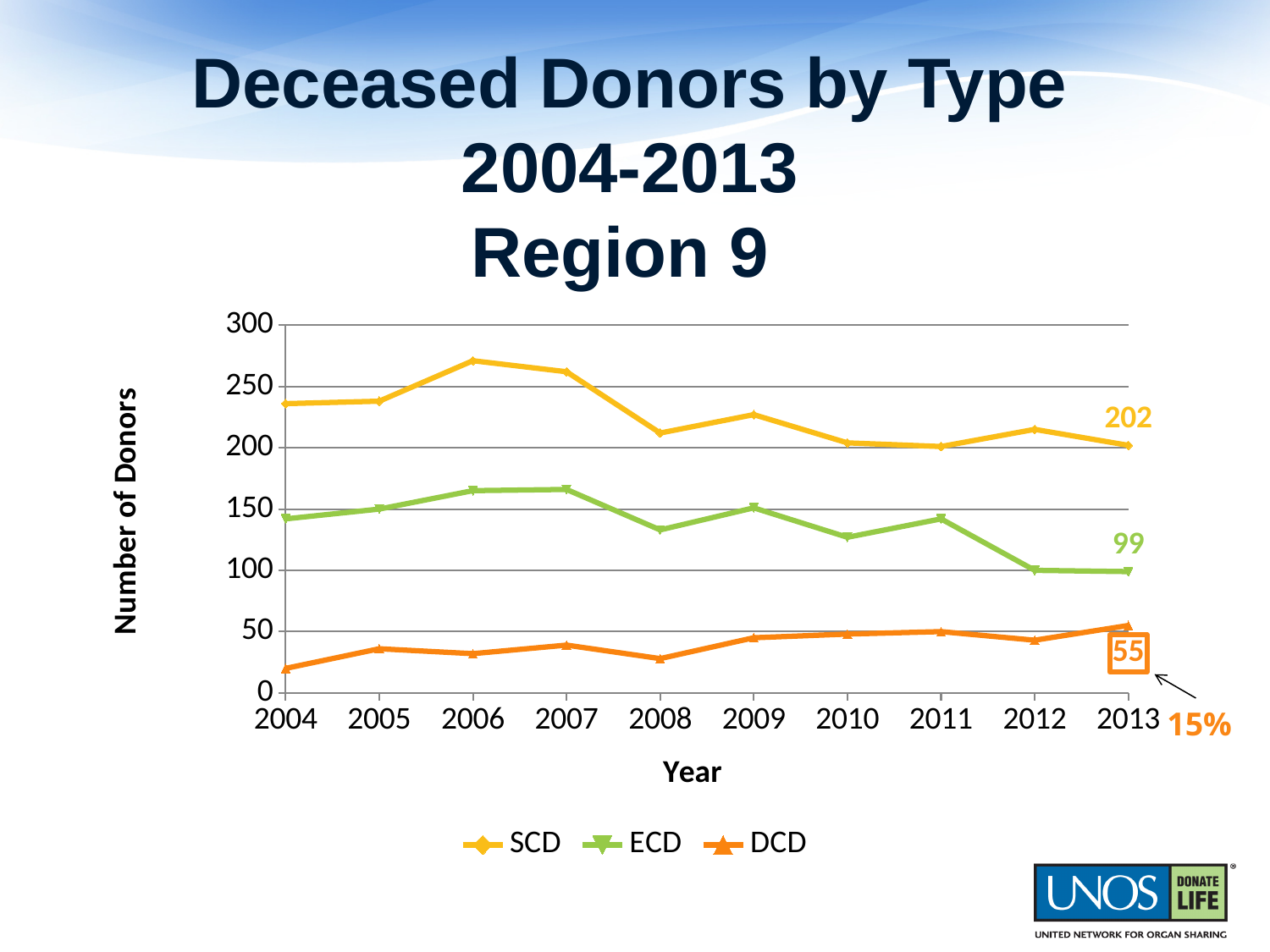
How many years are shown on the x axis? 10 What is the value for SCD in 2013? 202 What is the difference between the ECD and DCD values in 2013? 44 What kind of chart is shown on the slide? Line chart What is the value for ECD in 2013? 99 Is the value for ECD in 2007 greater or less than 150? greater Is the value for DCD in 2004 greater or less than 50? less What is the difference between the SCD and ECD values in 2013? 103 How many series does the legend list? 3 Is the value for SCD in 2006 greater or less than 250? greater What is the value for DCD in 2013? 55 In 2013, which series has the larger value, SCD or DCD? SCD